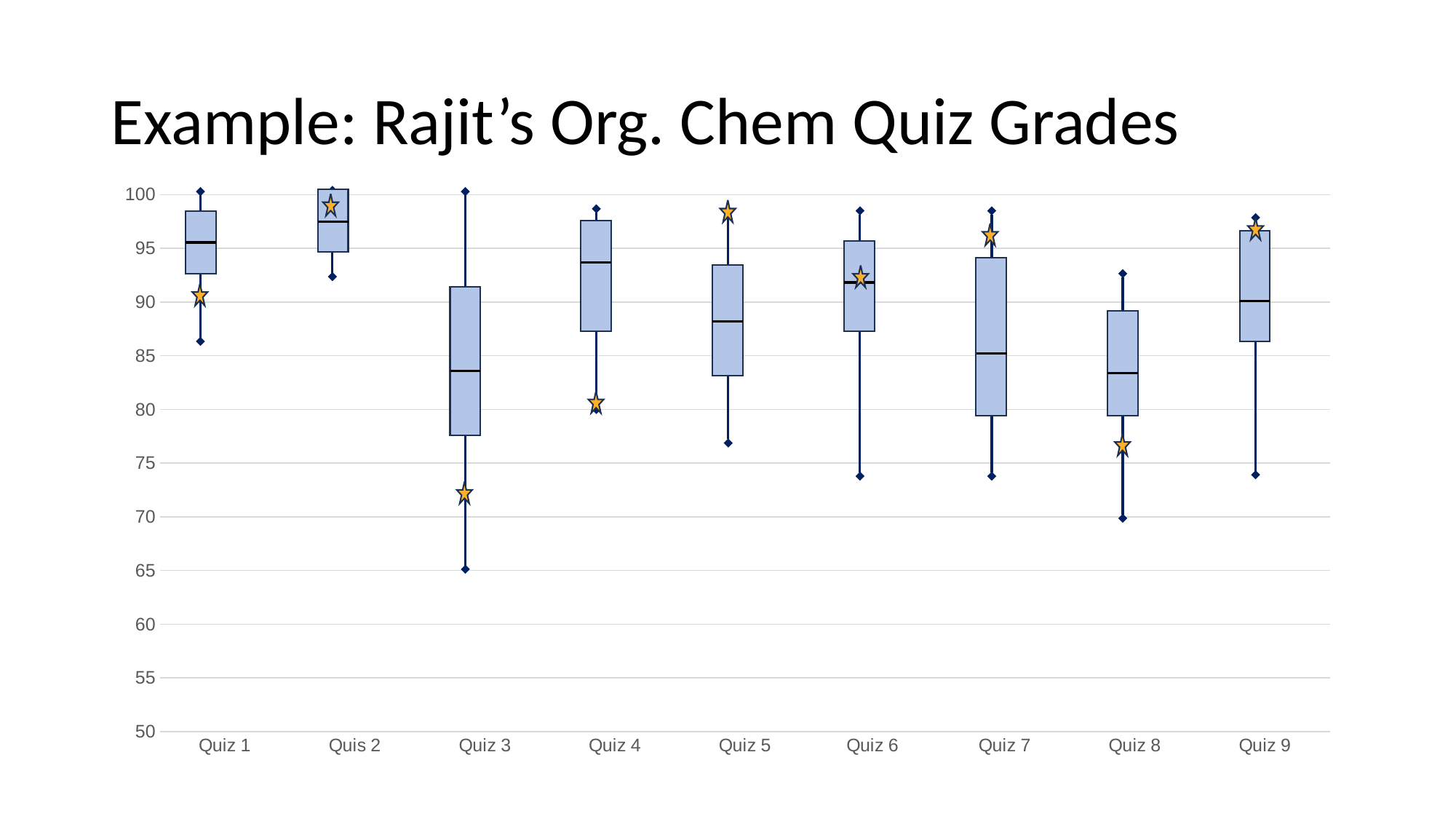
Is the minimum whisker value for Quiz 3 greater or less than 70? less How many quizzes are plotted on the x axis? 9 Which quiz has the highest median line? Quis 2 Is the star marker for Quiz 5 greater or less than 95? greater What kind of chart is shown on the slide? Box-and-whisker plot Which has the higher maximum whisker value, Quiz 4 or Quiz 8? Quiz 4 Is the star marker for Quiz 8 greater or less than 80? less What is the title of the slide? Example: Rajit's Org. Chem Quiz Grades Which quiz has the lowest star marker? Quiz 3 Which quiz has the lowest minimum whisker value? Quiz 3 Which has the higher median, Quiz 1 or Quiz 3? Quiz 1